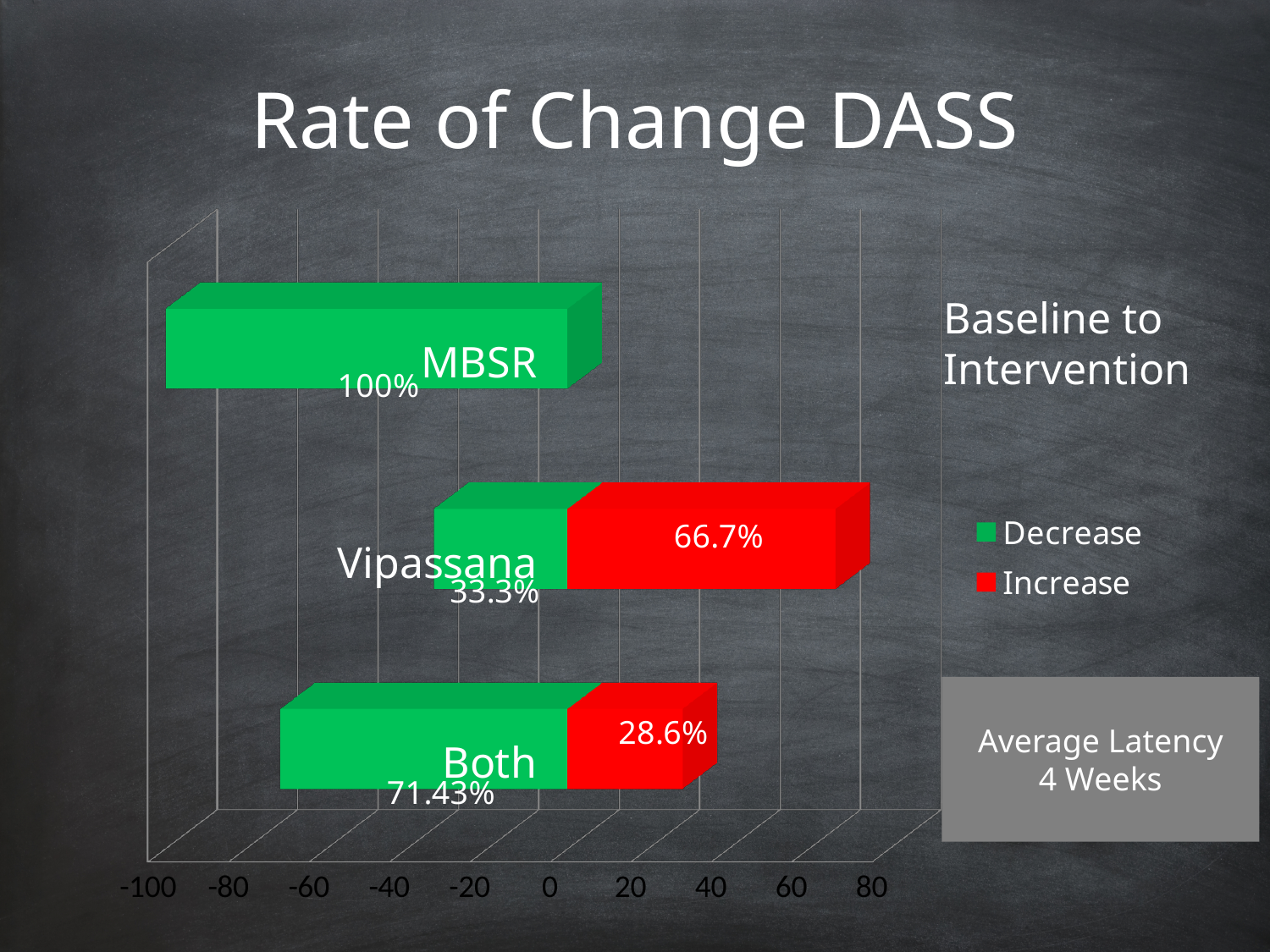
What is the Decrease value for Vipassana? 33.3% What is the Decrease value for Both? 71.43% Which category has the highest Decrease value? MBSR How many categories are shown on the chart? 3 What is the difference between the Increase values for Vipassana and Both? 38.1% What kind of chart is shown on the slide? Bar chart What is the Decrease value for MBSR? 100% How many series does the legend list? 2 What is the Increase value for Both? 28.6% Which category has the lowest Decrease value? Vipassana Which category has the larger Increase value, Vipassana or Both? Vipassana What is the Increase value for Vipassana? 66.7%